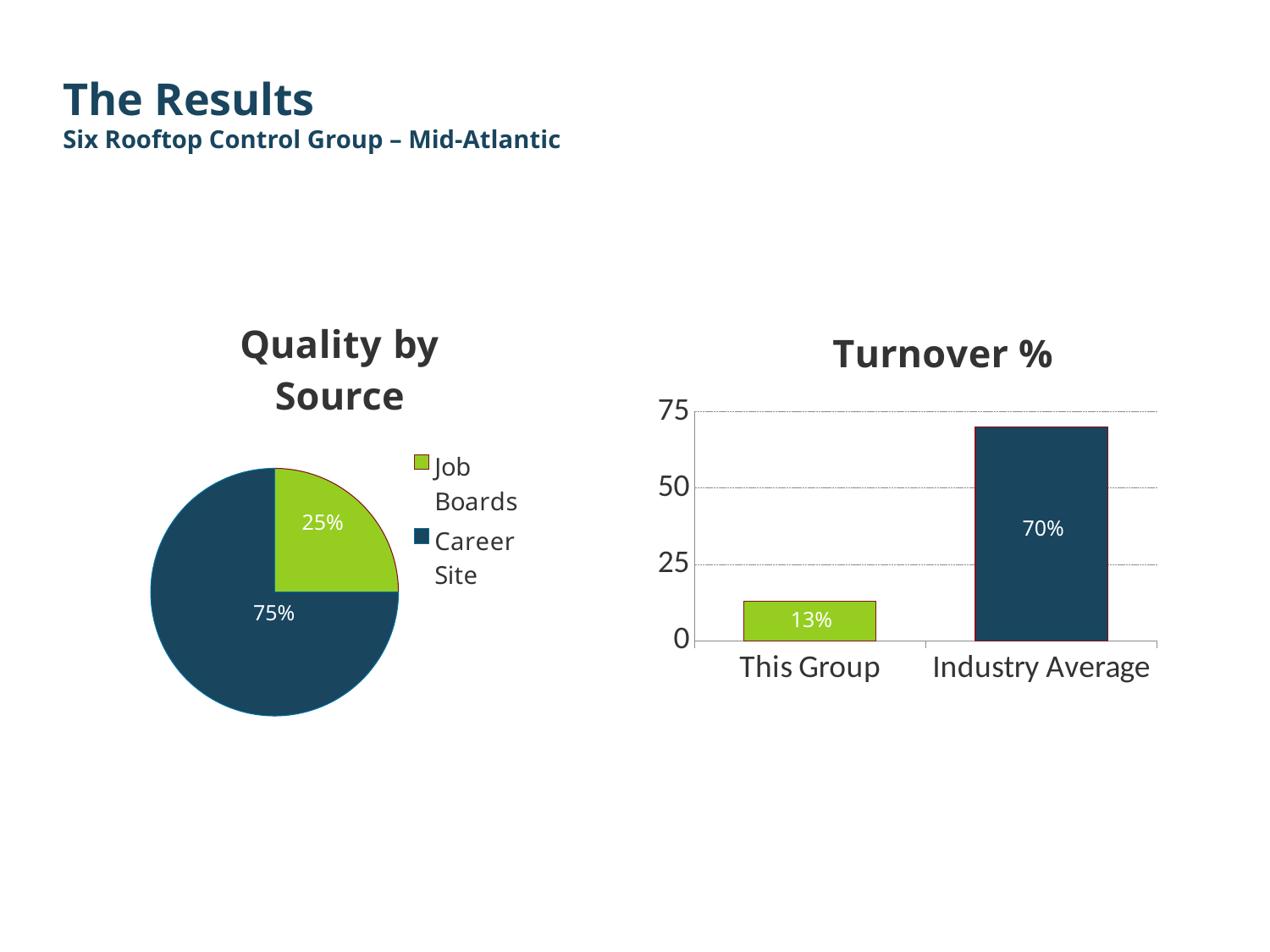
In the Quality by Source chart, what colour is the Job Boards slice? Green In the Quality by Source chart, what share of the pie is Career Site? 75% What kind of chart is the Quality by Source chart? Pie chart What kind of chart is the Turnover % chart? Bar chart In the Turnover % chart, which category has the highest value? Industry Average In the Turnover % chart, what is the value for This Group? 13% In the Turnover % chart, is the value for Industry Average greater or less than 50? greater In the Quality by Source chart, how many slices does the pie have? 2 In the Quality by Source chart, which source has the larger slice? Career Site In the Turnover % chart, what is the difference between Industry Average and This Group? 57% In the Turnover % chart, what is the value for Industry Average? 70% In the Quality by Source chart, what share of the pie is Job Boards? 25%